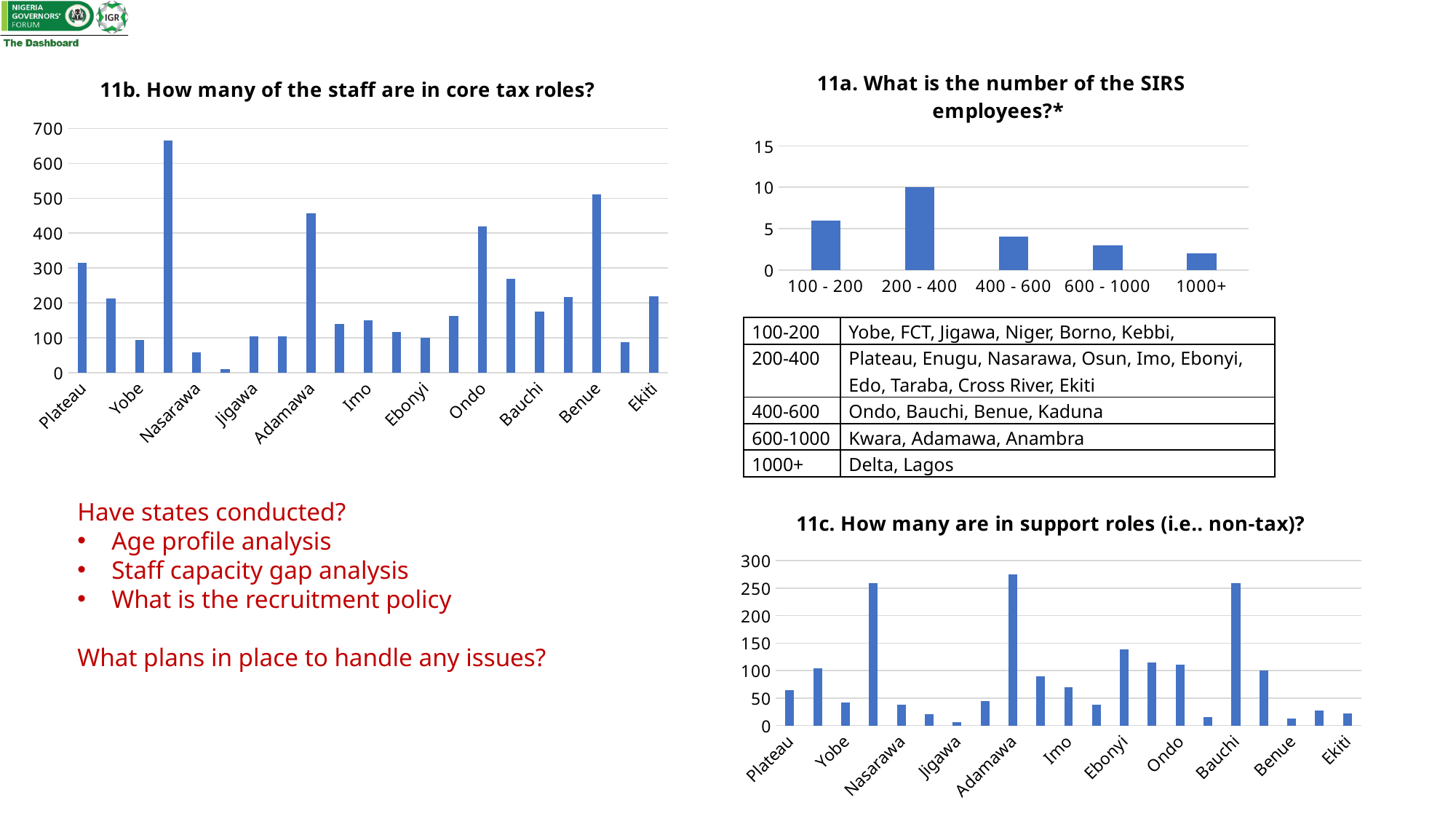
What kind of chart is '11b. How many of the staff are in core tax roles?'? bar chart How many categories are shown on the x axis of the chart '11a. What is the number of the SIRS employees?*'? 5 In the chart '11b. How many of the staff are in core tax roles?', is the value for Benue greater or less than 400? greater In the chart '11b. How many of the staff are in core tax roles?', is the value for Adamawa greater or less than 400? greater In the chart '11b. How many of the staff are in core tax roles?', which is larger, the value for Adamawa or the value for Imo? Adamawa In the chart '11a. What is the number of the SIRS employees?*', which category has the highest value? 200 - 400 In the chart '11c. How many are in support roles (i.e.. non-tax)?', is the value for Jigawa greater or less than 50? less In the chart '11a. What is the number of the SIRS employees?*', what is the value for the 200 - 400 category? 10 What is the title of the chart in the top right of the slide? 11a. What is the number of the SIRS employees?* In the chart '11c. How many are in support roles (i.e.. non-tax)?', which is larger, the value for Bauchi or the value for Benue? Bauchi